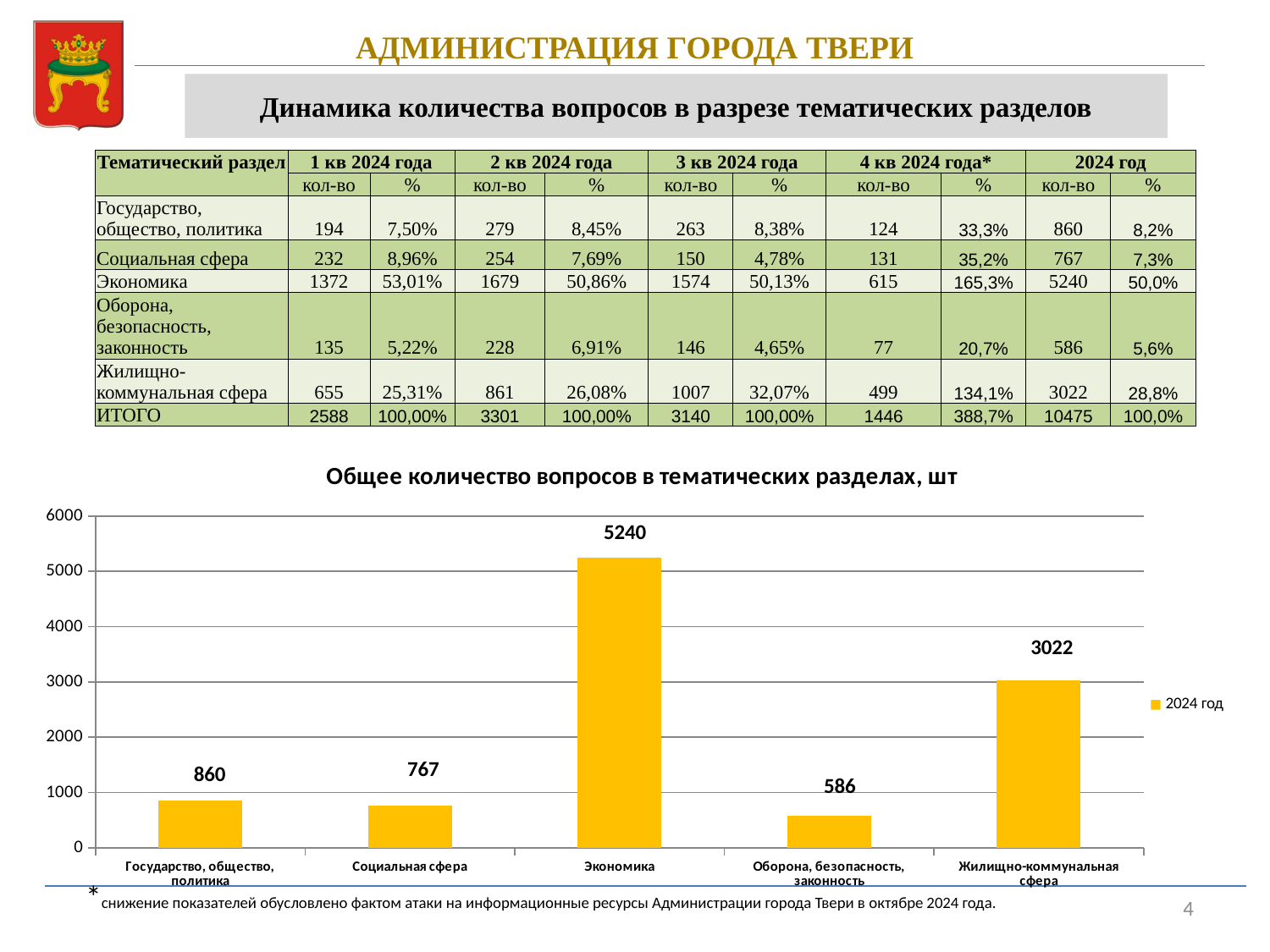
What type of chart is shown on the slide? bar chart Which category has the lowest value in the chart? Оборона, безопасность, законность What is the difference between the values for Экономика and Жилищно-коммунальная сфера? 2218 What is the difference between the values for Государство, общество, политика and Социальная сфера? 93 Which category has the highest value in the chart? Экономика Is the value for Жилищно-коммунальная сфера greater or less than 2000? greater What is the value for Оборона, безопасность, законность in the chart? 586 How many categories are shown in the chart? 5 What is the value for Жилищно-коммунальная сфера in the chart? 3022 What is the title of the chart? Общее количество вопросов в тематических разделах, шт What is the value for Экономика in the chart? 5240 Which is larger: the value for Государство, общество, политика or the value for Социальная сфера? Государство, общество, политика